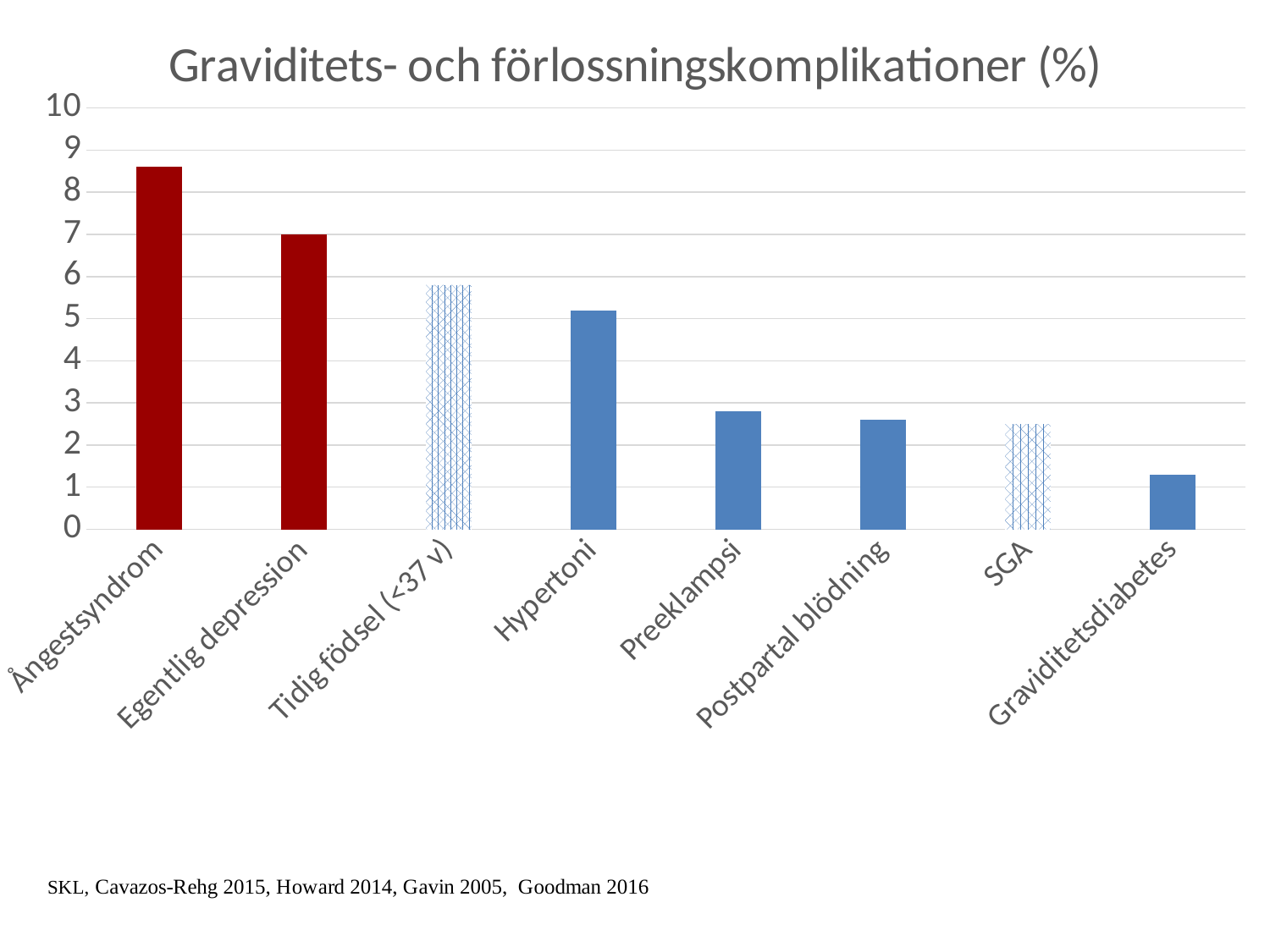
How many categories are plotted in the chart? 8 Is the value for Ångestsyndrom greater or less than 8? greater Is the value for Preeklampsi greater or less than 3? less What is the title of the chart? Graviditets- och förlossningskomplikationer (%) Which category has the lowest value? Graviditetsdiabetes Do the values rise or fall from left to right along the x axis? fall Which is larger, the value for Tidig födsel (<37 v) or the value for Hypertoni? Tidig födsel (<37 v) Which category has the highest value? Ångestsyndrom What is the value for Egentlig depression? 7 What kind of chart is shown on the slide? bar chart Is the value for Hypertoni greater or less than 5? greater